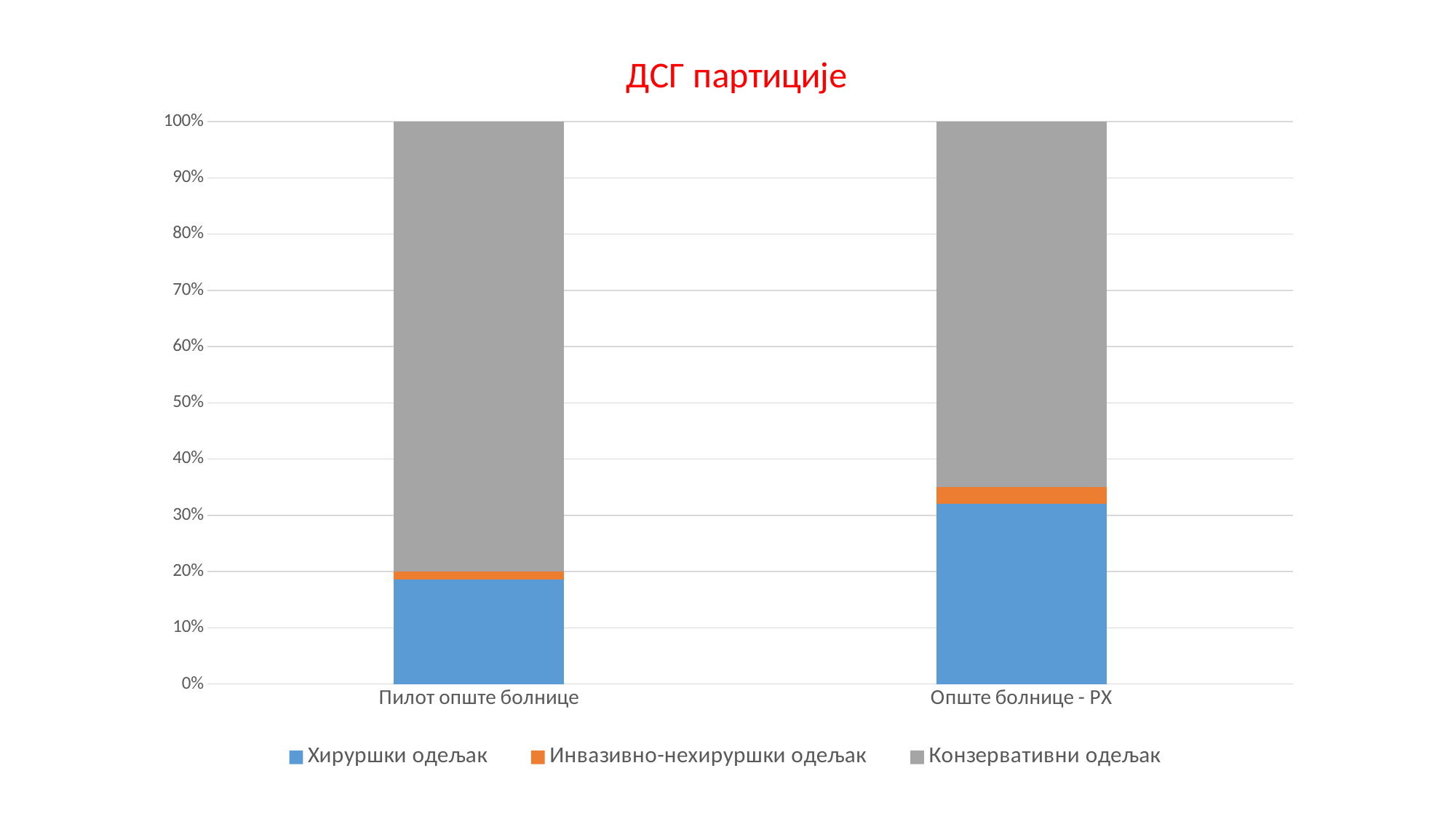
What is the title of the chart? ДСГ партиције Which category has the larger share for Хируршки одељак, Пилот опште болнице or Опште болнице - РХ? Опште болнице - РХ Is the value for Хируршки одељак in Опште болнице - РХ greater or less than 30%? greater How many categories are shown on the x axis? 2 How many series does the legend list? 3 Is the value for Конзервативни одељак in Пилот опште болнице greater or less than 70%? greater What is the total height of the stacked bar for Пилот опште болнице? 100% Is the value for Хируршки одељак in Пилот опште болнице greater or less than 20%? less Which category has the larger share for Конзервативни одељак, Пилот опште болнице or Опште болнице - РХ? Пилот опште болнице Which series is shown in grey in the legend? Конзервативни одељак What kind of chart is shown on the slide? stacked bar chart